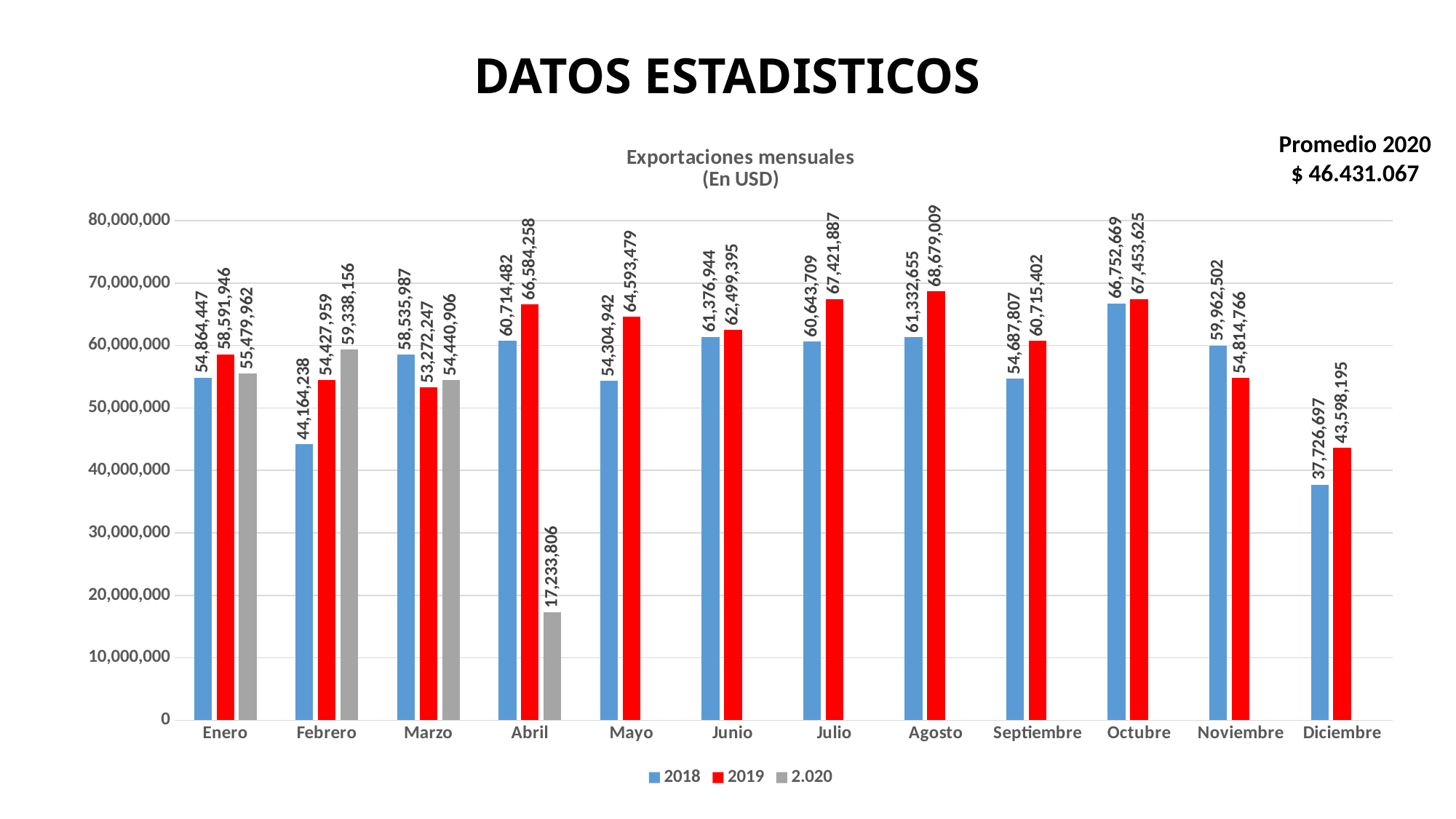
What kind of chart is shown on the slide? bar chart What is the value for 2.020 in Abril? 17,233,806 What is the value for 2019 in Agosto? 68,679,009 What is the difference between the 2019 and 2018 values in Abril? 5,869,776 How many months are shown on the x axis? 12 How many series does the legend list? 3 What is the value for 2018 in Febrero? 44,164,238 Which month has the lowest value for the 2018 series? Diciembre Which month has the highest value for the 2019 series? Agosto Is the value for 2019 in Diciembre greater or less than 40,000,000? greater In Marzo, which series has the larger value, 2018 or 2019? 2018 Do the 2018 values rise or fall from Octubre to Diciembre? fall